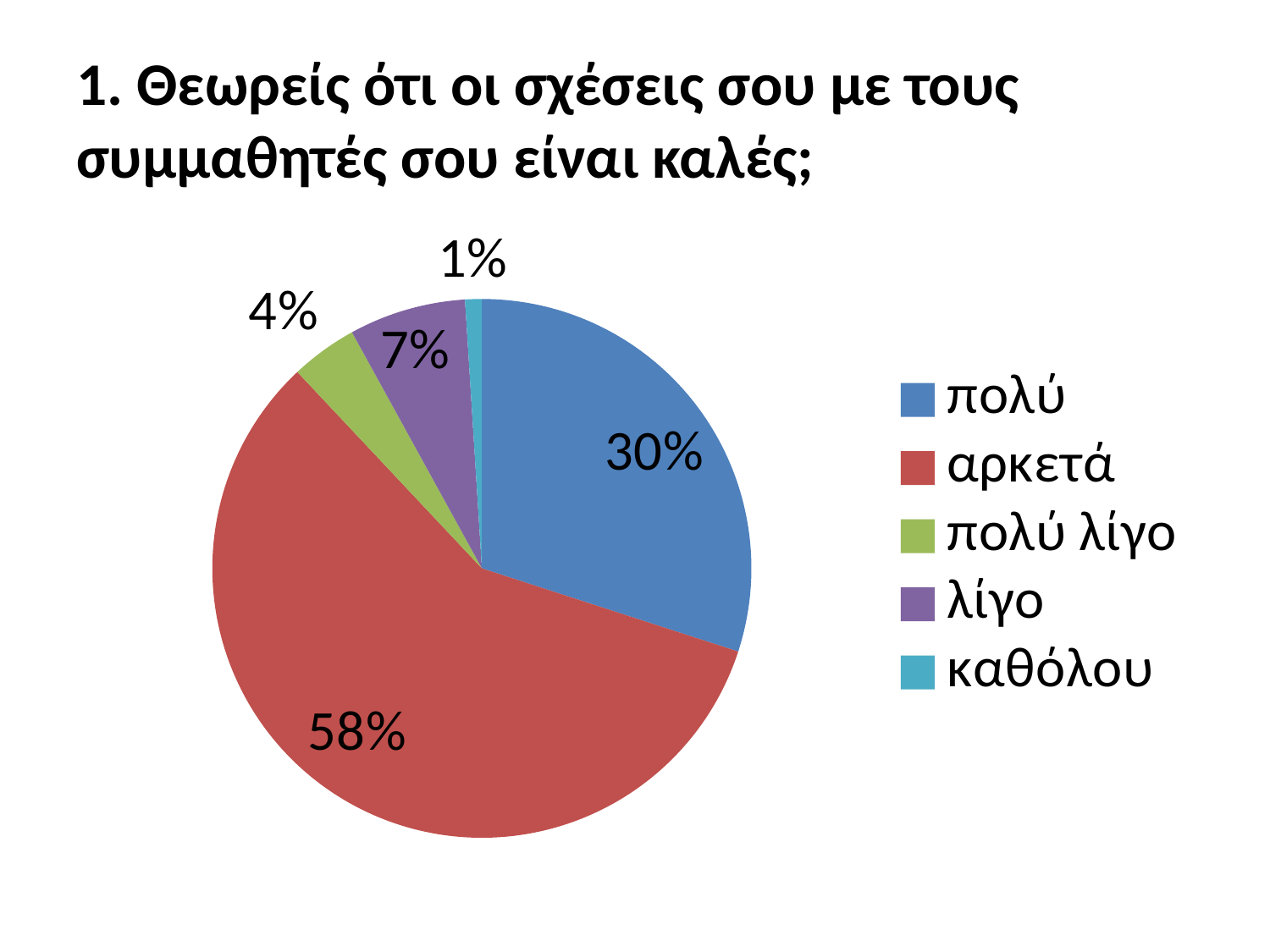
What kind of chart is shown on the slide? pie chart Which slice is larger, 'λίγο' or 'πολύ λίγο'? λίγο What colour is the 'αρκετά' slice? red What percentage of the pie is the 'πολύ' slice? 30% What percentage of the pie is the 'πολύ λίγο' slice? 4% What percentage of the pie is the 'καθόλου' slice? 1% What percentage of the pie is the 'αρκετά' slice? 58% What percentage of the pie is the 'λίγο' slice? 7% Which category has the smallest share of the pie? καθόλου What is the difference in percentage points between the 'αρκετά' and 'πολύ' slices? 28 Which category has the largest share of the pie? αρκετά How many categories does the pie chart show? 5